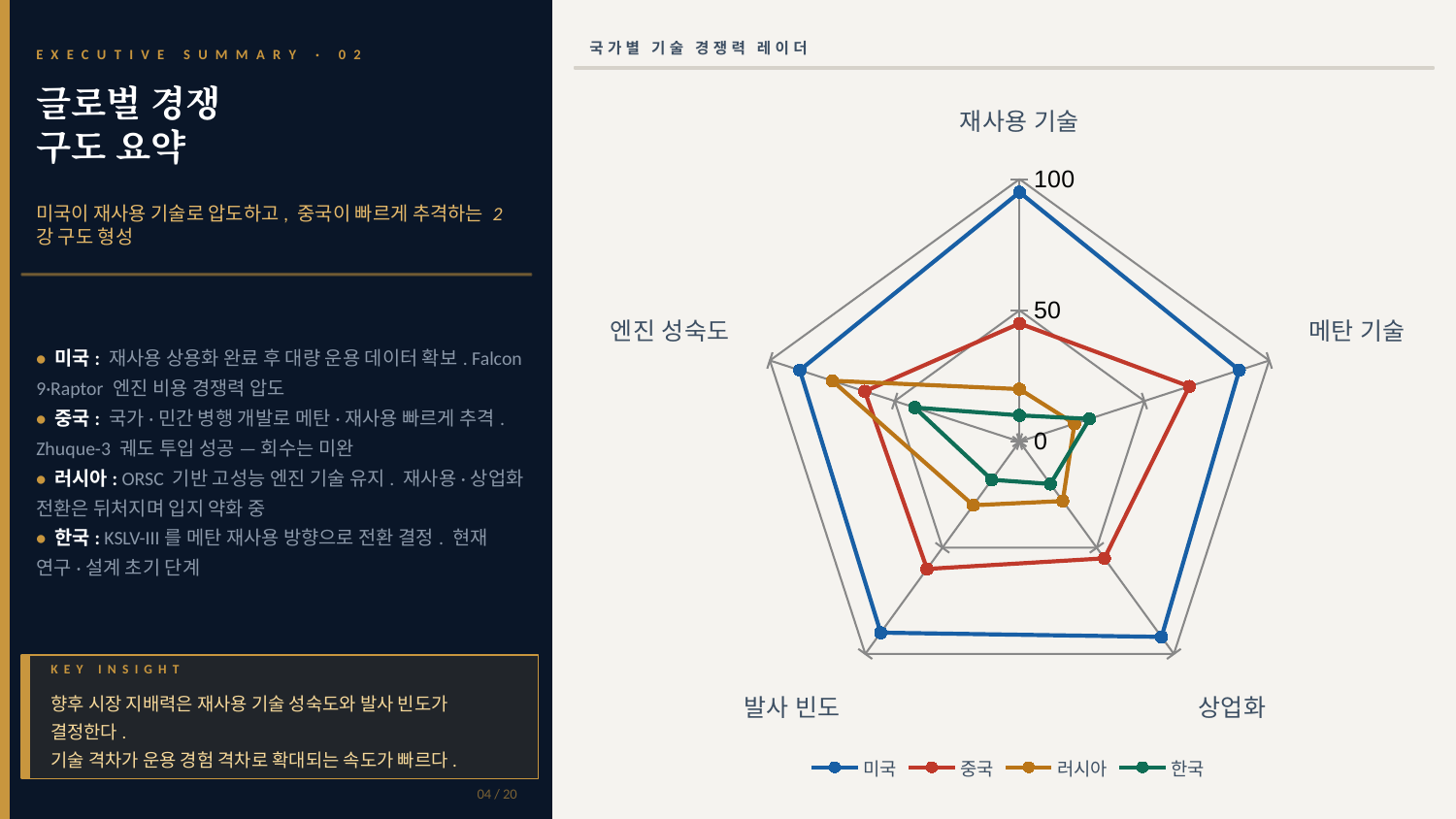
Is the value for 러시아 on 메탄 기술 greater or less than 50? less Which country has the highest value for 재사용 기술? 미국 How many axes (categories) does the radar chart have? 5 Which country has the lowest value for 재사용 기술? 한국 Which has the larger value for 발사 빈도, 중국 or 러시아? 중국 Is the value for 미국 on 메탄 기술 greater or less than 50? greater Is the value for 한국 on 재사용 기술 greater or less than 50? less Which country has the lowest value for 엔진 성숙도? 한국 How many series does the chart legend list? 4 What kind of chart is shown on the slide? Radar chart What is the title of the chart? 국가별 기술 경쟁력 레이더 Which country has the highest value for 발사 빈도? 미국